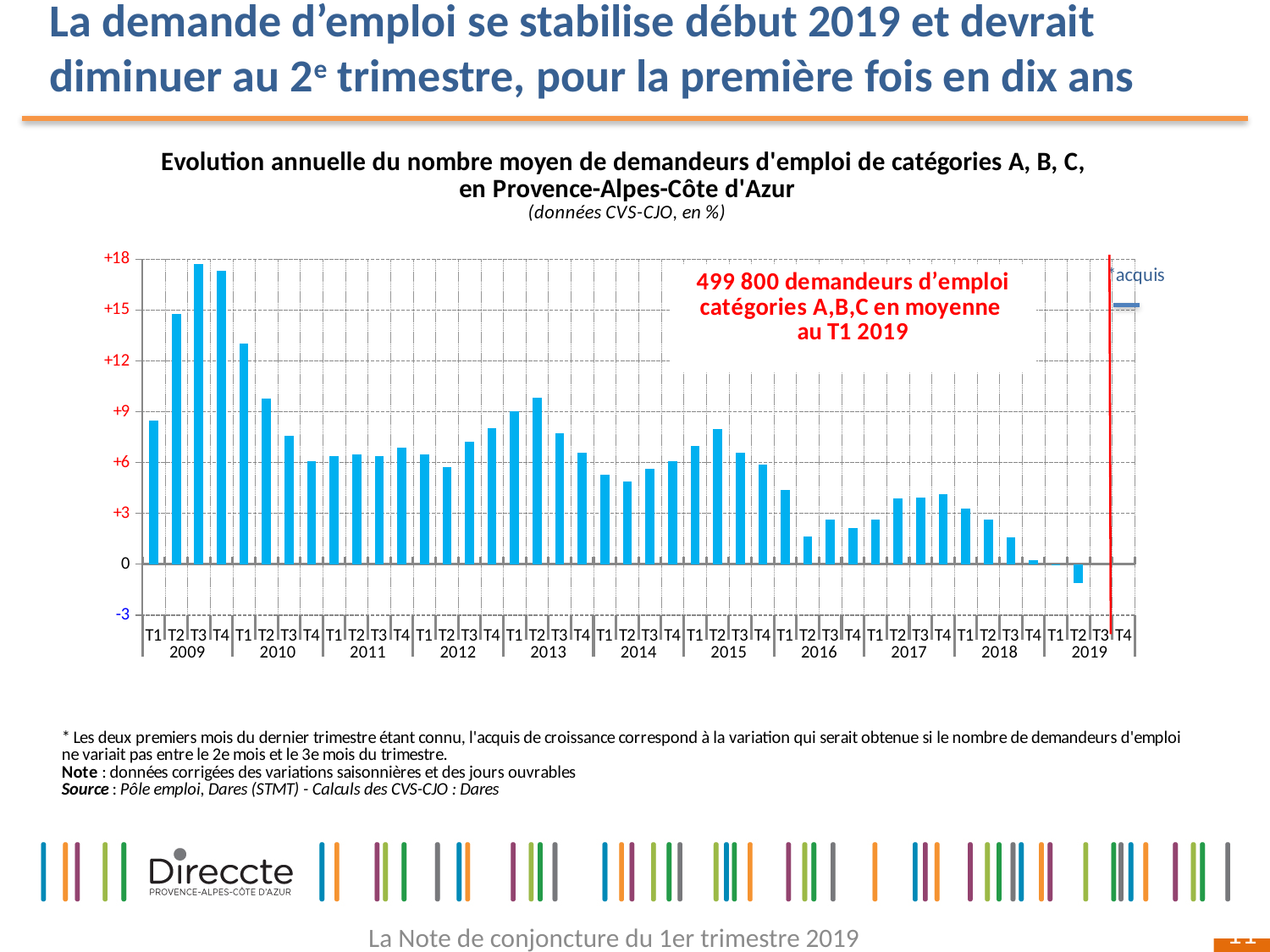
Is the value for T2 2016 greater or less than +3? less Which quarter has the lowest value in the chart? T2 2019 Is the value for T2 2009 greater or less than +12? greater Is the value for T1 2009 greater or less than +9? less How many years are labelled along the x axis of the chart? 11 According to the annotation on the chart, how many job seekers in categories A, B, C were there on average in T1 2019? 499 800 Which is larger, the value for T1 2009 or the value for T2 2009? T2 2009 Which is larger, the value for T1 2010 or the value for T1 2018? T1 2010 Overall, do the values rise or fall from 2009 to 2019? fall What kind of chart is shown on the slide? bar chart